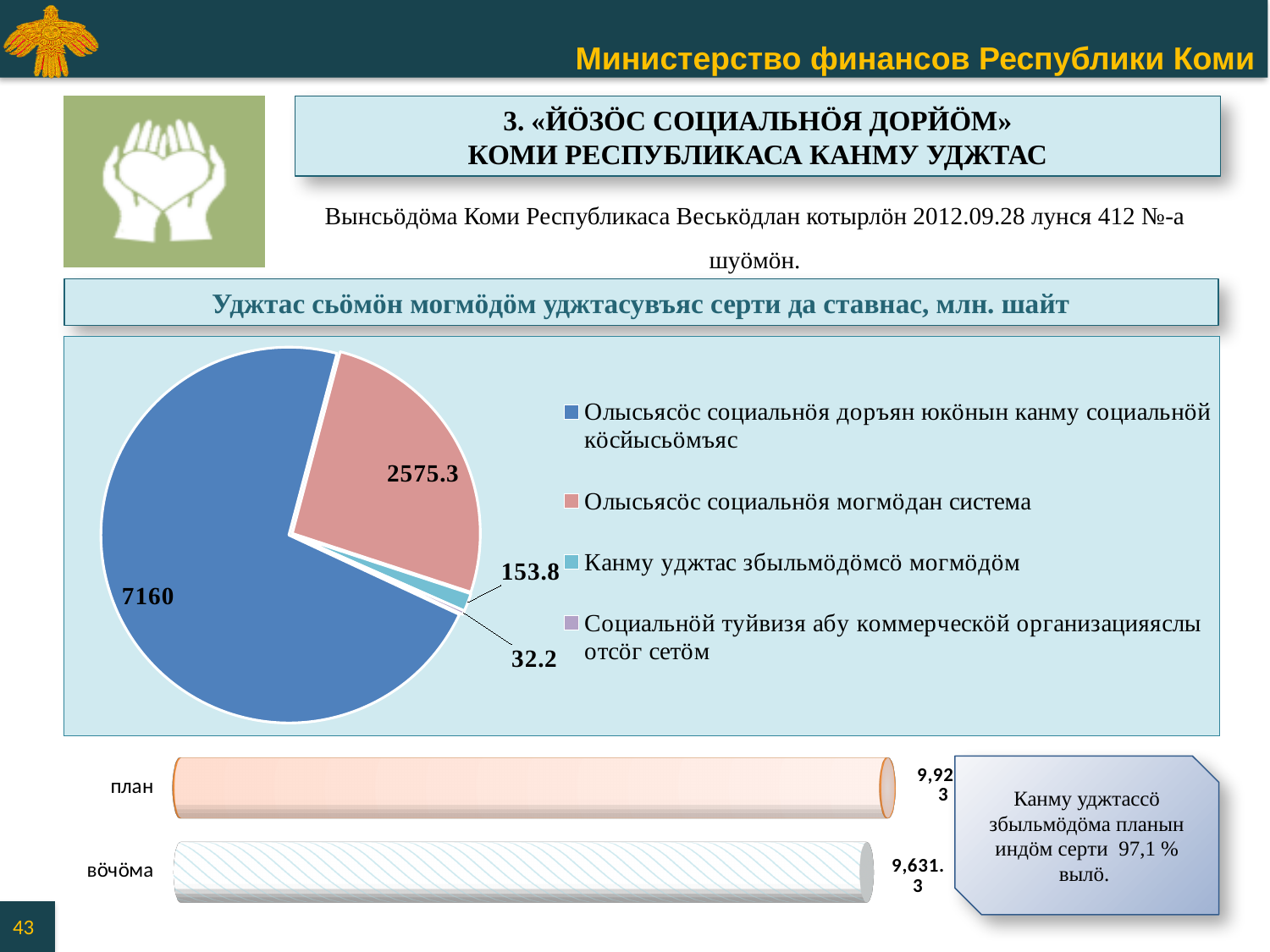
What kind of chart is the lower chart on the slide showing "план" and "вöчöма"? bar chart What kind of chart is the upper chart on the slide? pie chart How many entries does the legend of the pie chart list? 4 In the lower bar chart, which is larger: "план" or "вöчöма"? план In the pie chart, which category has the smallest slice? Социальнöй туйвизя абу коммерческöй организацияяслы отсöг сетöм In the lower bar chart, what is the value for "вöчöма"? 9,631.3 In the pie chart, which is larger: "Канму уджтас збыльмöдöмсö могмöдöм" or "Социальнöй туйвизя абу коммерческöй организацияяслы отсöг сетöм"? Канму уджтас збыльмöдöмсö могмöдöм In the pie chart, what is the value for "Олысьясöс социальнöя могмöдан система"? 2575.3 How many slices does the pie chart have? 4 In the pie chart, what is the value of the largest slice? 7160 In the pie chart, what is the difference between the largest slice (7160) and the slice labelled 2575.3? 4584.7